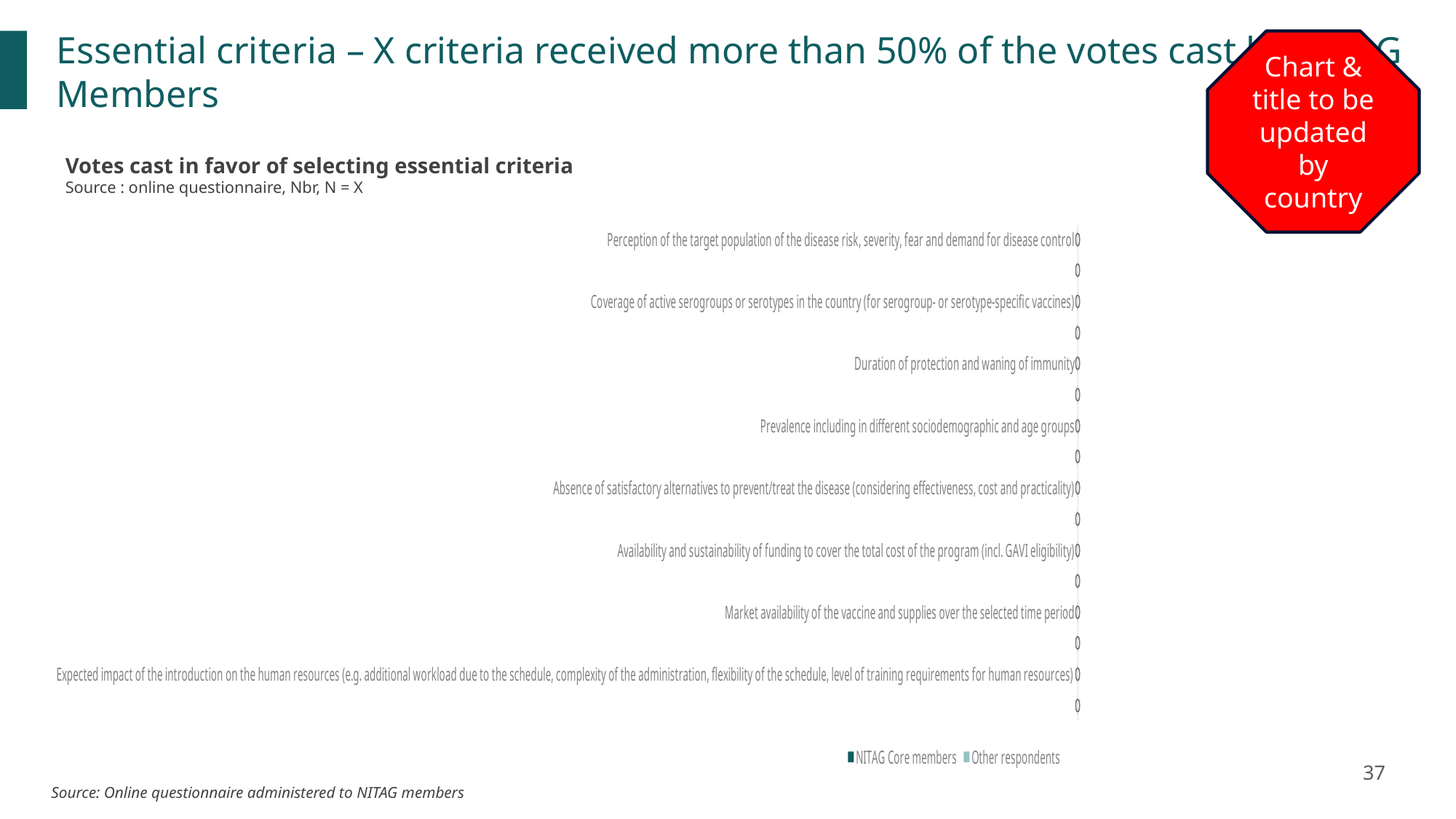
What are the two series named in the legend? NITAG Core members and Other respondents What is the value for NITAG Core members for 'Availability and sustainability of funding to cover the total cost of the program (incl. GAVI eligibility)'? 0 What is the value for Other respondents for 'Market availability of the vaccine and supplies over the selected time period'? 0 What is the value for NITAG Core members for 'Prevalence including in different sociodemographic and age groups'? 0 What is the title of the chart? Votes cast in favor of selecting essential criteria What is the difference between the NITAG Core members value and the Other respondents value for 'Duration of protection and waning of immunity'? 0 How many series does the legend list? 2 What is the value for NITAG Core members for 'Duration of protection and waning of immunity'? 0 What is the value for Other respondents for 'Absence of satisfactory alternatives to prevent/treat the disease (considering effectiveness, cost and practicality)'? 0 What is the value for Other respondents for 'Coverage of active serogroups or serotypes in the country (for serogroup- or serotype-specific vaccines)'? 0